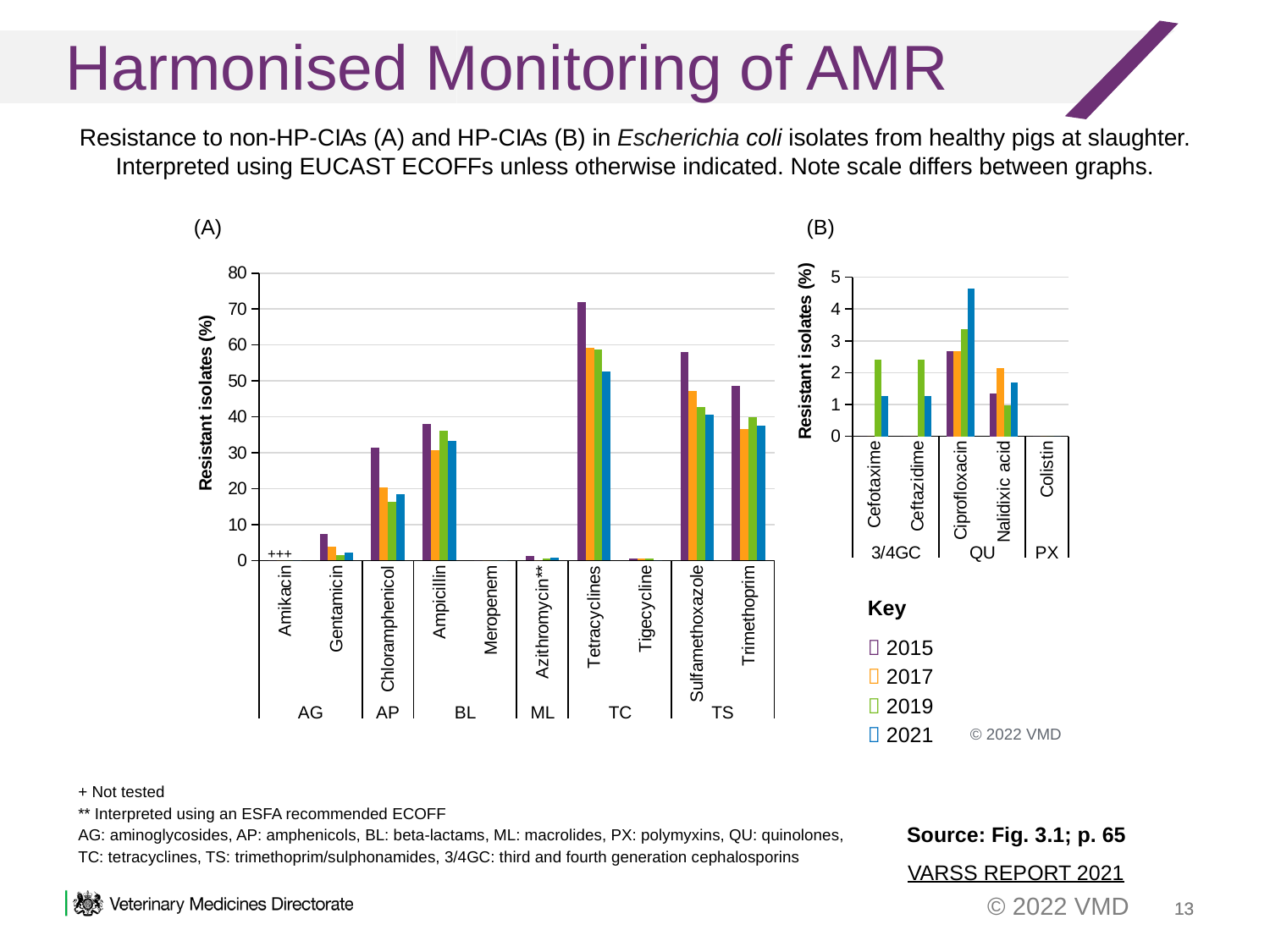
In chart (A), which antimicrobial has the highest 2015 bar? Tetracyclines In chart (B), which is larger for 2021: Ciprofloxacin or Nalidixic acid? Ciprofloxacin How many antimicrobial categories are shown on the x axis of chart (A)? 10 In chart (A), is the 2015 value for Ampicillin greater or less than 40? less In chart (A), is the 2015 value for Tetracyclines greater or less than 70? greater In chart (B), which antimicrobial has the highest bar overall? Ciprofloxacin How many years does the key list for the charts? 4 What kind of chart is chart (A)? bar chart How many antimicrobial categories are shown on the x axis of chart (B)? 5 In chart (B), is the 2021 value for Ciprofloxacin greater or less than 4? greater What is the y-axis label of chart (B)? Resistant isolates (%) In chart (A), does the value for Tetracyclines rise or fall from 2015 to 2021? fall